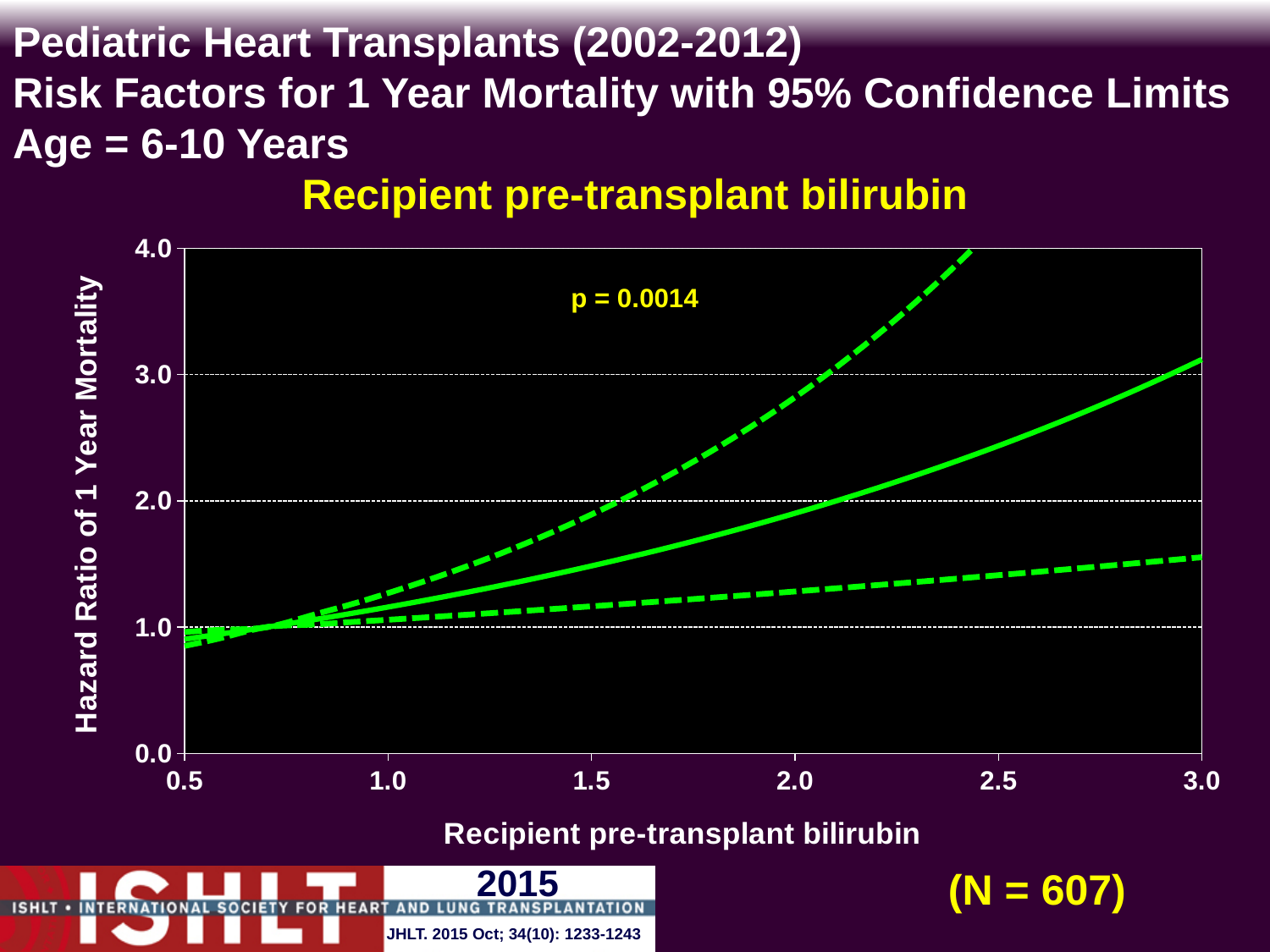
How many lines are plotted on the chart? 3 Does the solid hazard ratio line rise or fall as recipient pre-transplant bilirubin increases from 0.5 to 3.0? rise Is the upper dashed confidence limit at a bilirubin of 2.5 greater or less than 3.0? greater What sample size (N) is shown on the slide? N = 607 Is the lower dashed confidence limit at a bilirubin of 3.0 greater or less than 2.0? less Is the solid hazard ratio line at a bilirubin of 2.5 greater or less than 3.0? less What kind of chart is shown on the slide? line chart What p-value is shown on the chart? p = 0.0014